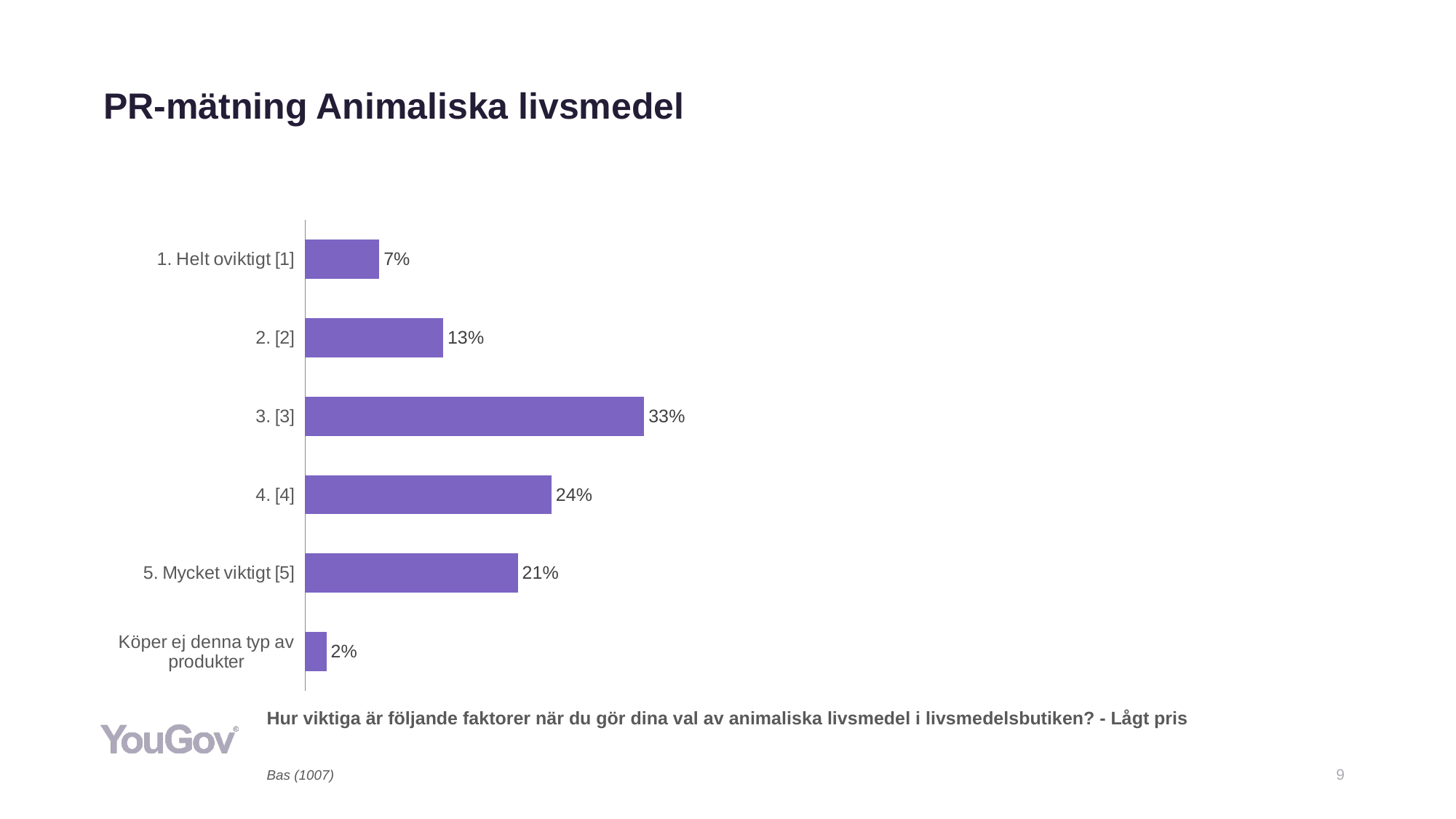
What is the value for "1. Helt oviktigt [1]"? 7% What kind of chart is shown on the slide? Bar chart What is the difference between the values for "3. [3]" and "1. Helt oviktigt [1]"? 26% What is the value for "5. Mycket viktigt [5]"? 21% Which category has the highest value? 3. [3] What is the base (Bas) stated below the chart? 1007 What is the value for "3. [3]"? 33% How many categories are shown in the chart? 6 What is the value for "Köper ej denna typ av produkter"? 2% Which category has the lowest value? Köper ej denna typ av produkter Which is larger, the value for "4. [4]" or the value for "5. Mycket viktigt [5]"? 4. [4] What is the difference between the values for "4. [4]" and "2. [2]"? 11%